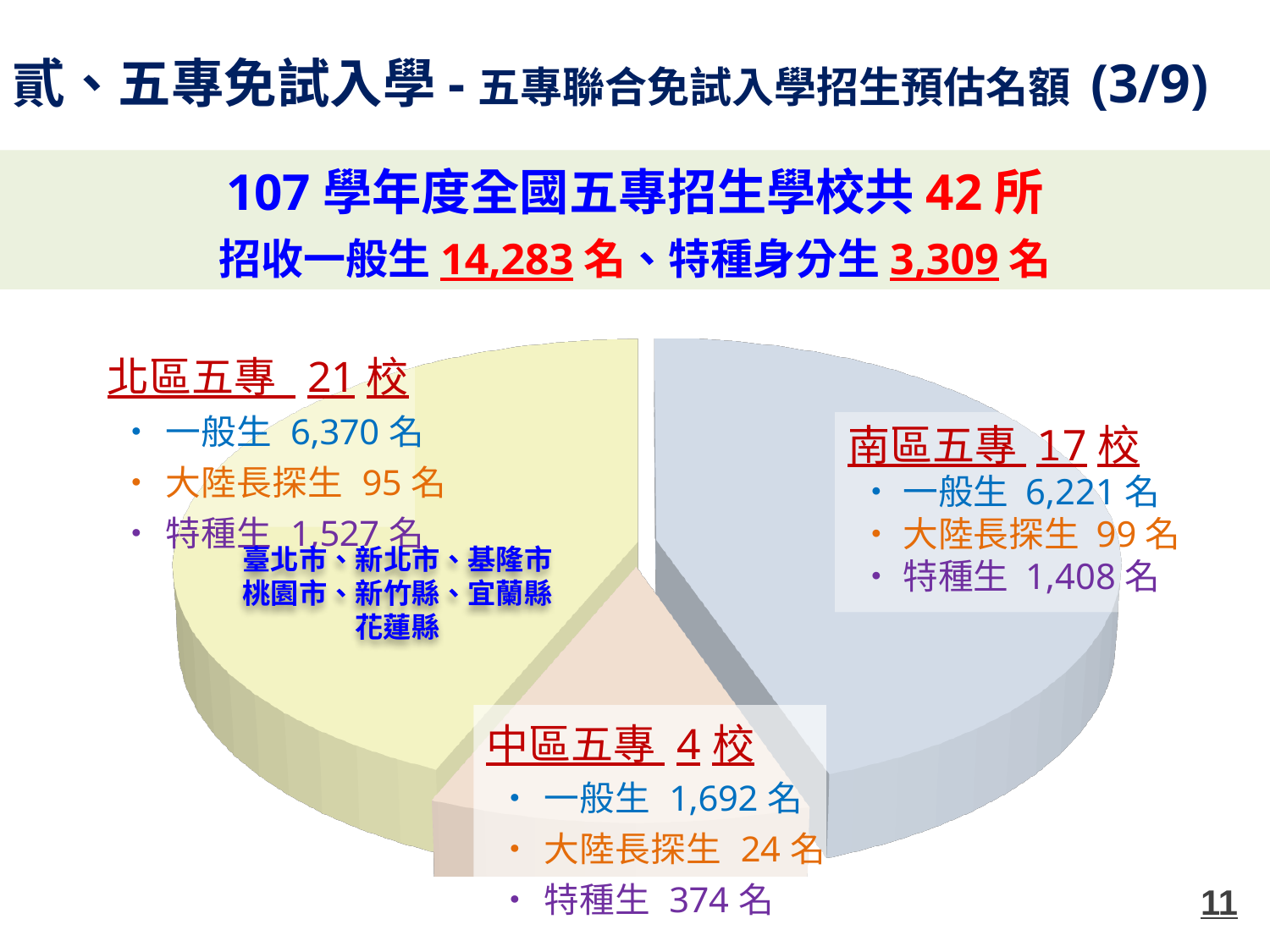
How many schools (校) does 南區五專 have according to the chart? 17 校 Which region is represented by the yellow slice of the pie chart? 北區五專 Which has more 大陸長探生, 北區五專 or 南區五專? 南區五專 What type of chart is shown on the slide? pie chart How many 大陸長探生 are listed for 南區五專? 99 名 What is the 特種生 value for 中區五專? 374 名 How many slices does the pie chart have? 3 What is the difference between the 一般生 values of 北區五專 and 南區五專? 149 What is the difference between the 特種生 values of 北區五專 and 中區五專? 1,153 Which region has the smallest slice of the pie chart? 中區五專 What is the 一般生 value for 中區五專? 1,692 名 What is the number of 一般生 for 北區五專 shown on the pie chart? 6,370 名